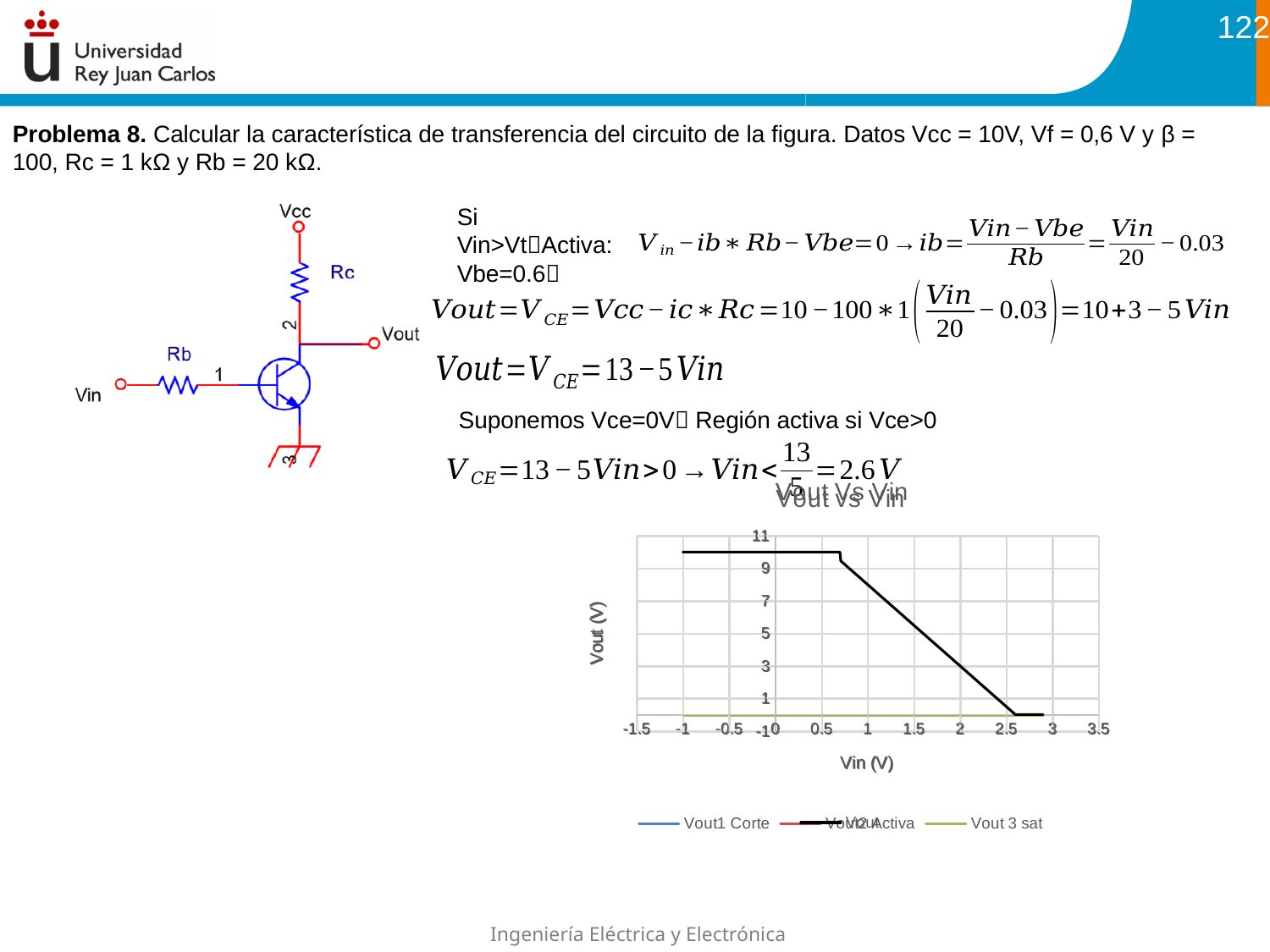
Which is larger, Vout at Vin = 0 or Vout at Vin = 2? Vout at Vin = 0 Is the value of Vout at Vin = -1 greater or less than 7? greater Is the value of Vout at Vin = 2 greater or less than 5? less What kind of chart is shown on the slide? line chart Is the value of Vout at Vin = 1.5 greater or less than 3? greater How many series does the chart legend list? 3 What is the title of the chart on the slide? Vout Vs Vin What is the label of the vertical axis of the chart? Vout (V) Between Vin = 1 and Vin = 2, does Vout rise or fall? fall